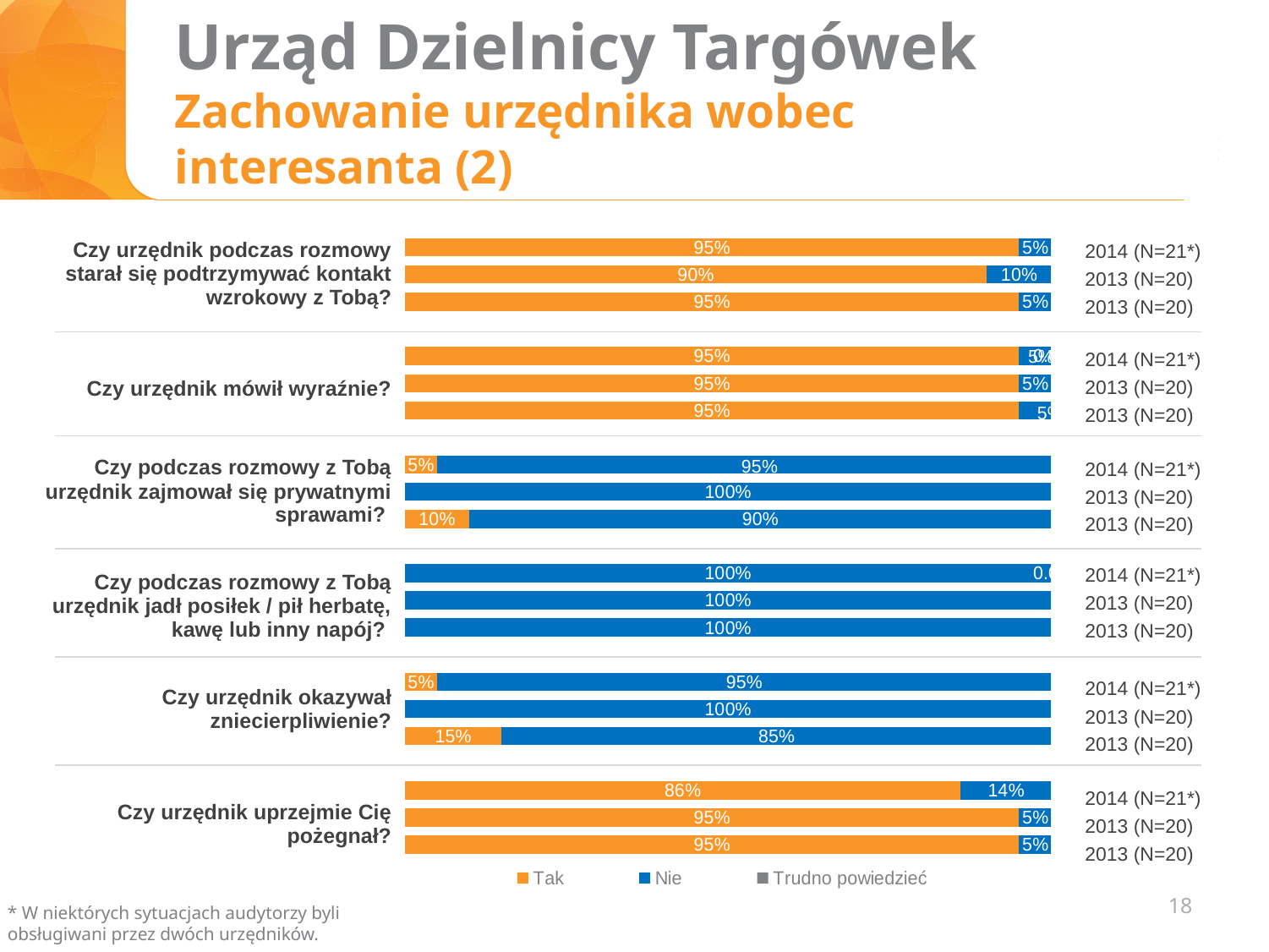
How many survey questions are shown in the chart? 6 What is the "Nie" value for 2014 (N=21*) for "Czy podczas rozmowy z Tobą urzędnik zajmował się prywatnymi sprawami?"? 95% For "Czy urzędnik podczas rozmowy starał się podtrzymywać kontakt wzrokowy z Tobą?", by how many percentage points does the 2014 (N=21*) "Tak" value exceed the middle 2013 (N=20) "Tak" value? 5 percentage points What is the "Nie" value for 2014 (N=21*) for "Czy podczas rozmowy z Tobą urzędnik jadł posiłek / pił herbatę, kawę lub inny napój?"? 100% What is the "Tak" value for 2014 (N=21*) for "Czy urzędnik podczas rozmowy starał się podtrzymywać kontakt wzrokowy z Tobą?"? 95% What percentage answered "Nie" in 2014 (N=21*) for "Czy urzędnik uprzejmie Cię pożegnał?"? 14% What kind of chart is shown on the slide? Stacked bar chart What percentage answered "Tak" in 2014 (N=21*) for "Czy urzędnik uprzejmie Cię pożegnał?"? 86% In the bottom 2013 (N=20) bar for "Czy urzędnik okazywał zniecierpliwienie?", what is the "Tak" value? 15% How many series does the chart legend list? 3 Which colour represents "Tak" in the chart legend? Orange In 2014 (N=21*), which question has the higher "Tak" share: "Czy urzędnik uprzejmie Cię pożegnał?" or "Czy urzędnik podczas rozmowy starał się podtrzymywać kontakt wzrokowy z Tobą?"? Czy urzędnik podczas rozmowy starał się podtrzymywać kontakt wzrokowy z Tobą?